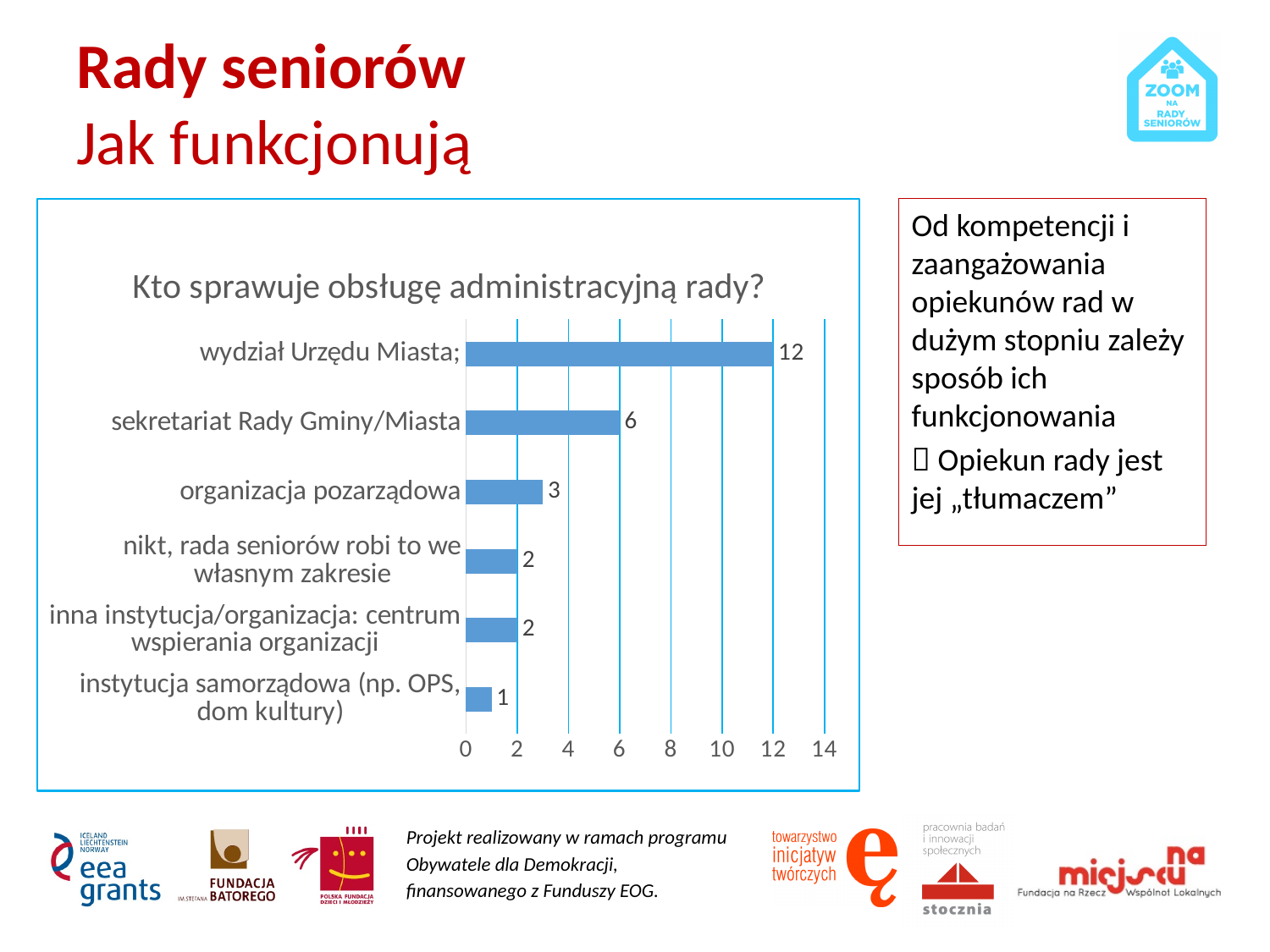
Which category has the highest value? wydział Urzędu Miasta What is the value for "sekretariat Rady Gminy/Miasta"? 6 What is the value for "instytucja samorządowa (np. OPS, dom kultury)"? 1 How many categories are shown in the chart? 6 Which is larger: the value for "organizacja pozarządowa" or the value for "nikt, rada seniorów robi to we własnym zakresie"? organizacja pozarządowa What is the value for "wydział Urzędu Miasta"? 12 What is the difference between the values for "wydział Urzędu Miasta" and "sekretariat Rady Gminy/Miasta"? 6 Is the value for "wydział Urzędu Miasta" greater or less than 10? greater What is the value for "organizacja pozarządowa"? 3 Which category has the lowest value? instytucja samorządowa (np. OPS, dom kultury) What is the title of the chart? Kto sprawuje obsługę administracyjną rady? What kind of chart is shown on the slide? bar chart